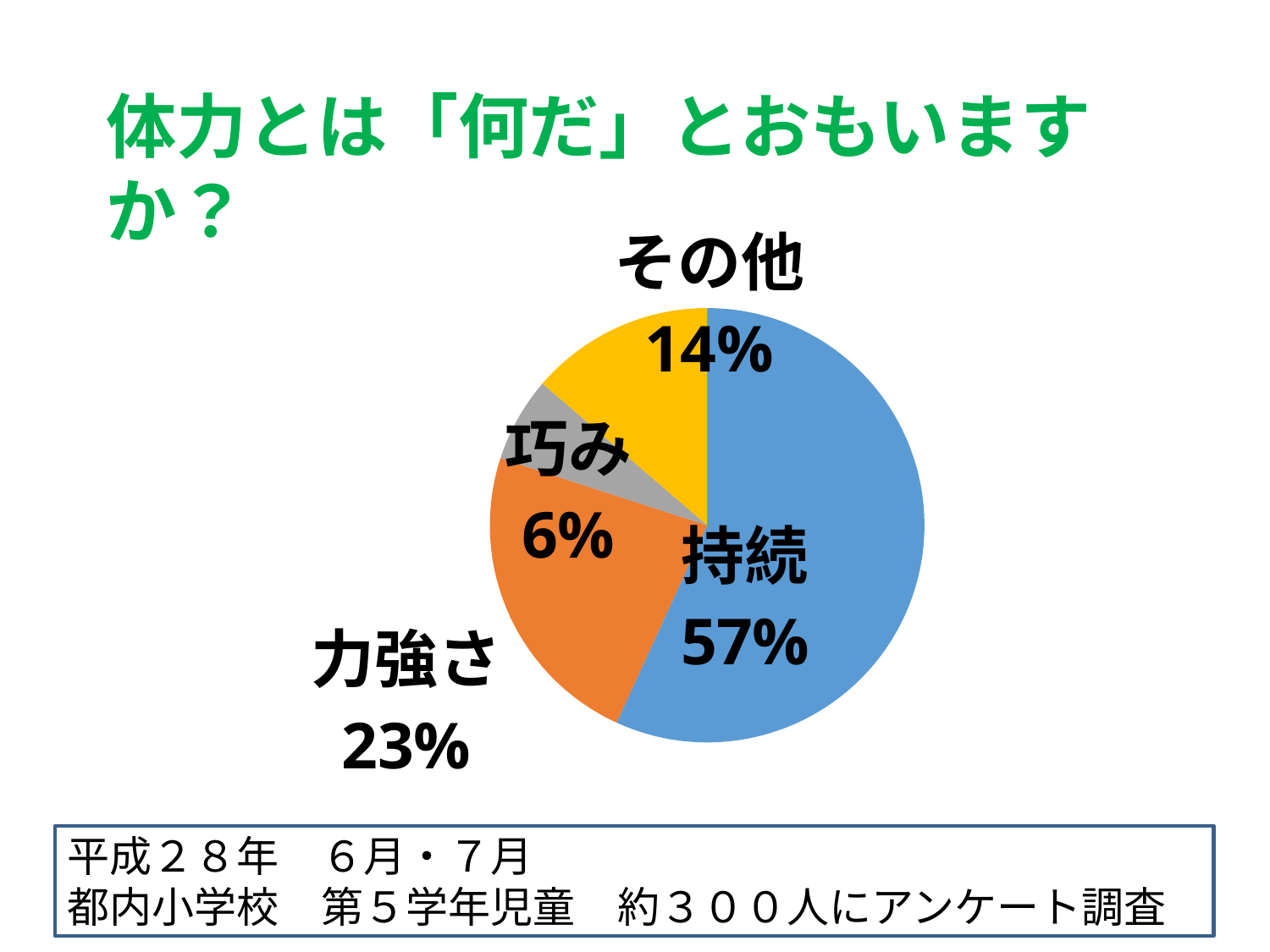
Which category has the smallest slice of the pie? 巧み How many categories are shown in the pie chart? 4 Which is larger, the share for 力強さ or the share for その他? 力強さ What colour is the slice for 持続? blue What is the difference in percentage points between その他 and 巧み? 8 What share of the pie does 持続 have? 57% What kind of chart is shown on the slide? pie chart What share of the pie does その他 have? 14% What share of the pie does 力強さ have? 23% What is the difference in percentage points between 持続 and 力強さ? 34 What share of the pie does 巧み have? 6% Which category has the largest slice of the pie? 持続